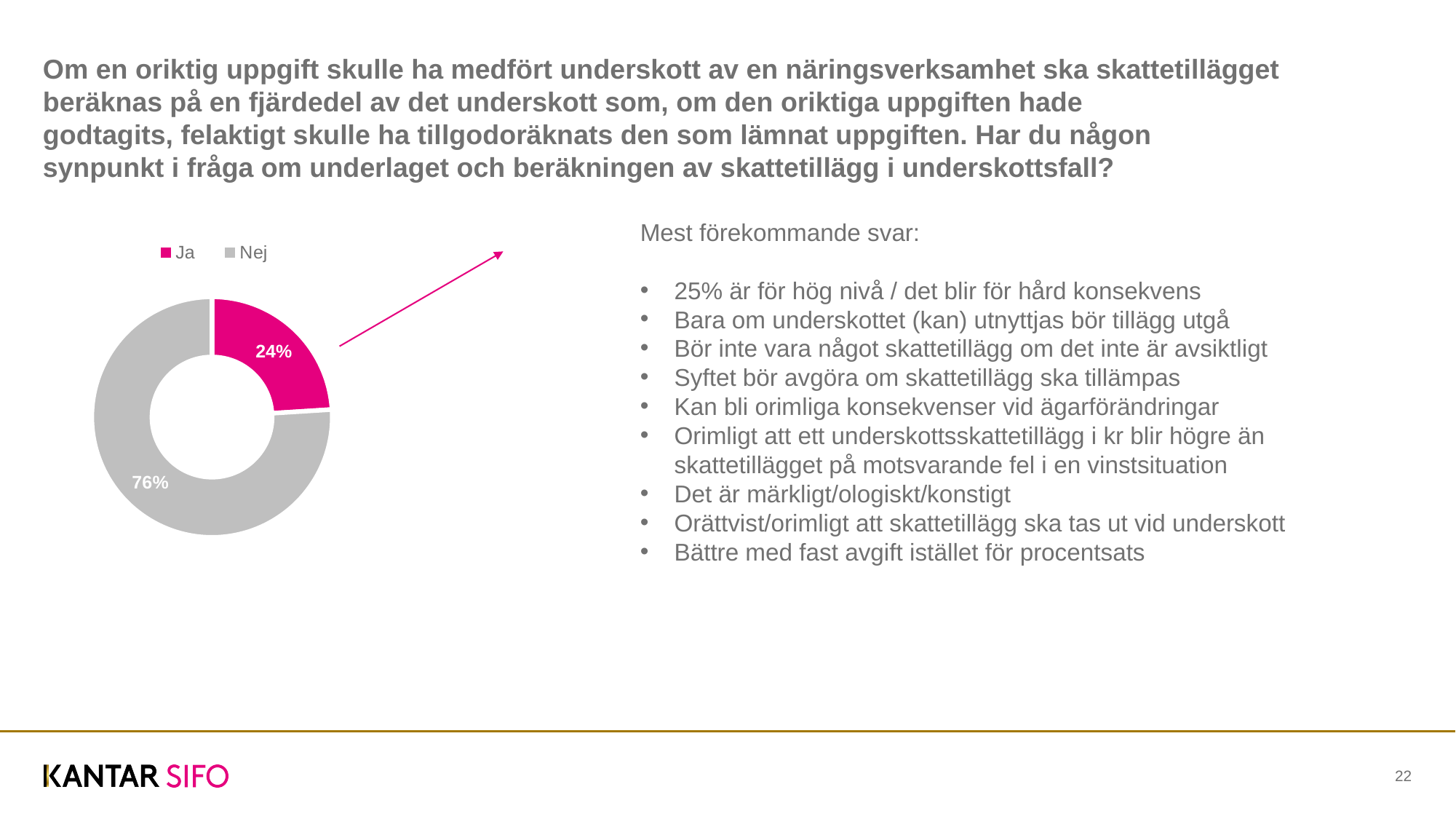
What colour is the "Ja" slice in the chart? Pink (magenta) Which is larger, the share for "Ja" or the share for "Nej"? Nej How many entries does the chart legend list? 2 How many categories does the pie chart show? 2 What share of the pie does the "Ja" slice represent? 24% What is the difference in percentage points between the "Nej" and "Ja" shares? 52 What percentage of respondents answered "Ja"? 24% What percentage of respondents answered "Nej"? 76% Which response has the smallest share of the pie? Ja Which response has the largest share of the pie? Nej What colour is the "Nej" slice in the chart? Grey What kind of chart is shown on the slide? Pie chart (doughnut)